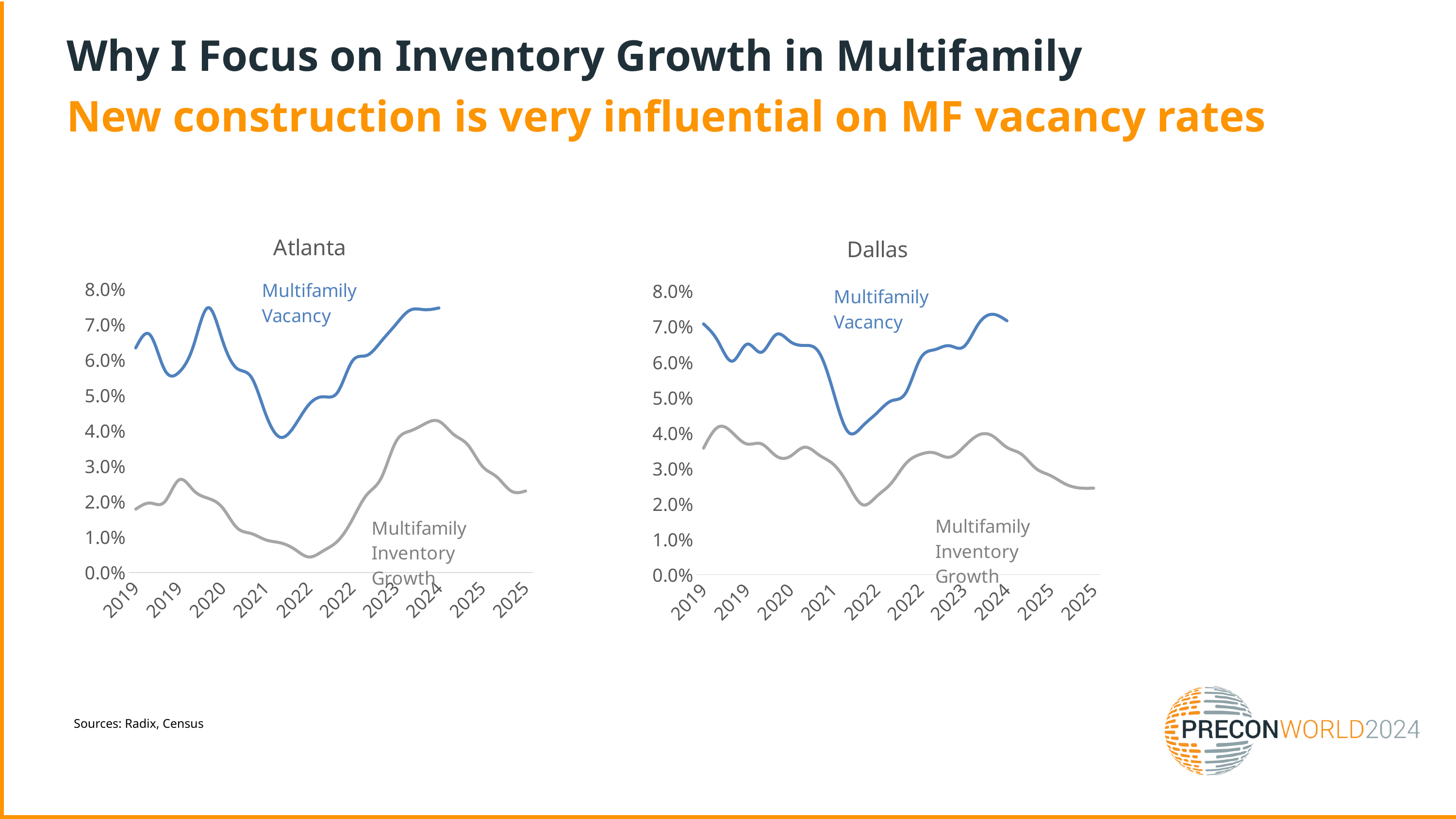
What kind of chart is the Atlanta chart? line chart On the Dallas chart, is the Multifamily Inventory Growth value at the final point (2025) greater or less than 3.0%? less On the Atlanta chart, which series has the higher value at the first point (2019), Multifamily Vacancy or Multifamily Inventory Growth? Multifamily Vacancy On the Atlanta chart, does Multifamily Inventory Growth rise or fall between 2024 and 2025? fall On the Atlanta chart, is the lowest value of Multifamily Inventory Growth greater or less than 1.0%? less How many year labels are shown on the x axis of the Dallas chart? 10 On the Atlanta chart, is the peak value of Multifamily Inventory Growth greater or less than 4.0%? greater On the Dallas chart, does Multifamily Vacancy rise or fall between 2022 and 2024? rise On the Atlanta chart, which series is drawn in blue? Multifamily Vacancy How many series are plotted on the Dallas chart? 2 What are the titles of the two charts on the slide? Atlanta and Dallas